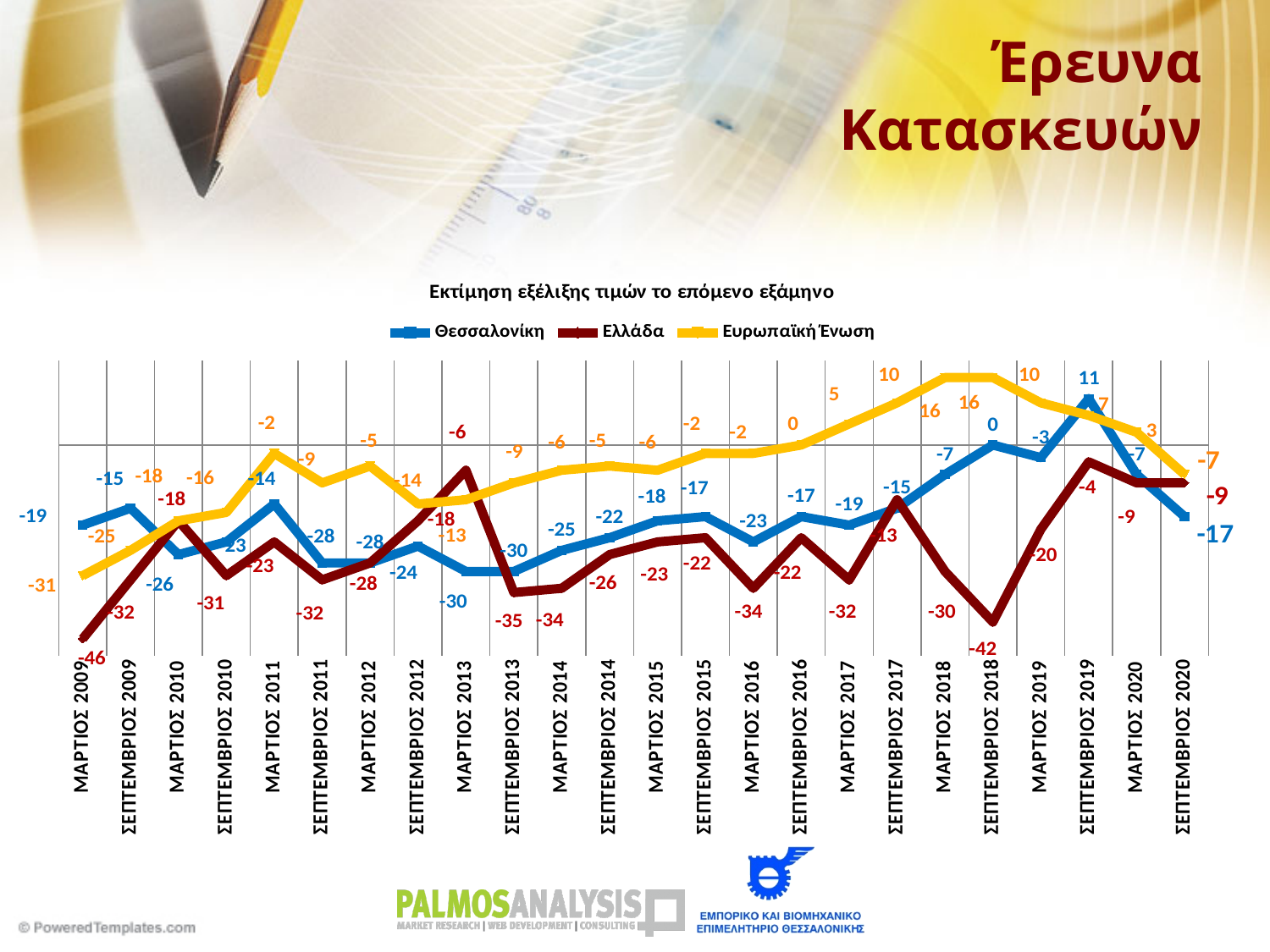
What is the value for Θεσσαλονίκη at ΣΕΠΤΕΜΒΡΙΟΣ 2020? -17 What is the value for Ελλάδα at ΣΕΠΤΕΜΒΡΙΟΣ 2020? -9 At which time point does Θεσσαλονίκη reach its highest value? ΣΕΠΤΕΜΒΡΙΟΣ 2019 What is the value for Θεσσαλονίκη at ΜΑΡΤΙΟΣ 2009? -19 How many series does the chart legend list? 3 At which time point does Ελλάδα reach its lowest value? ΜΑΡΤΙΟΣ 2009 What is the value for Ελλάδα at ΜΑΡΤΙΟΣ 2009? -46 Which series is drawn in yellow? Ευρωπαϊκή Ένωση What is the title of the chart? Εκτίμηση εξέλιξης τιμών το επόμενο εξάμηνο How many time points are shown on the x axis? 24 At ΣΕΠΤΕΜΒΡΙΟΣ 2020, which is higher: Ευρωπαϊκή Ένωση or Θεσσαλονίκη? Ευρωπαϊκή Ένωση What kind of chart is shown on the slide? line chart